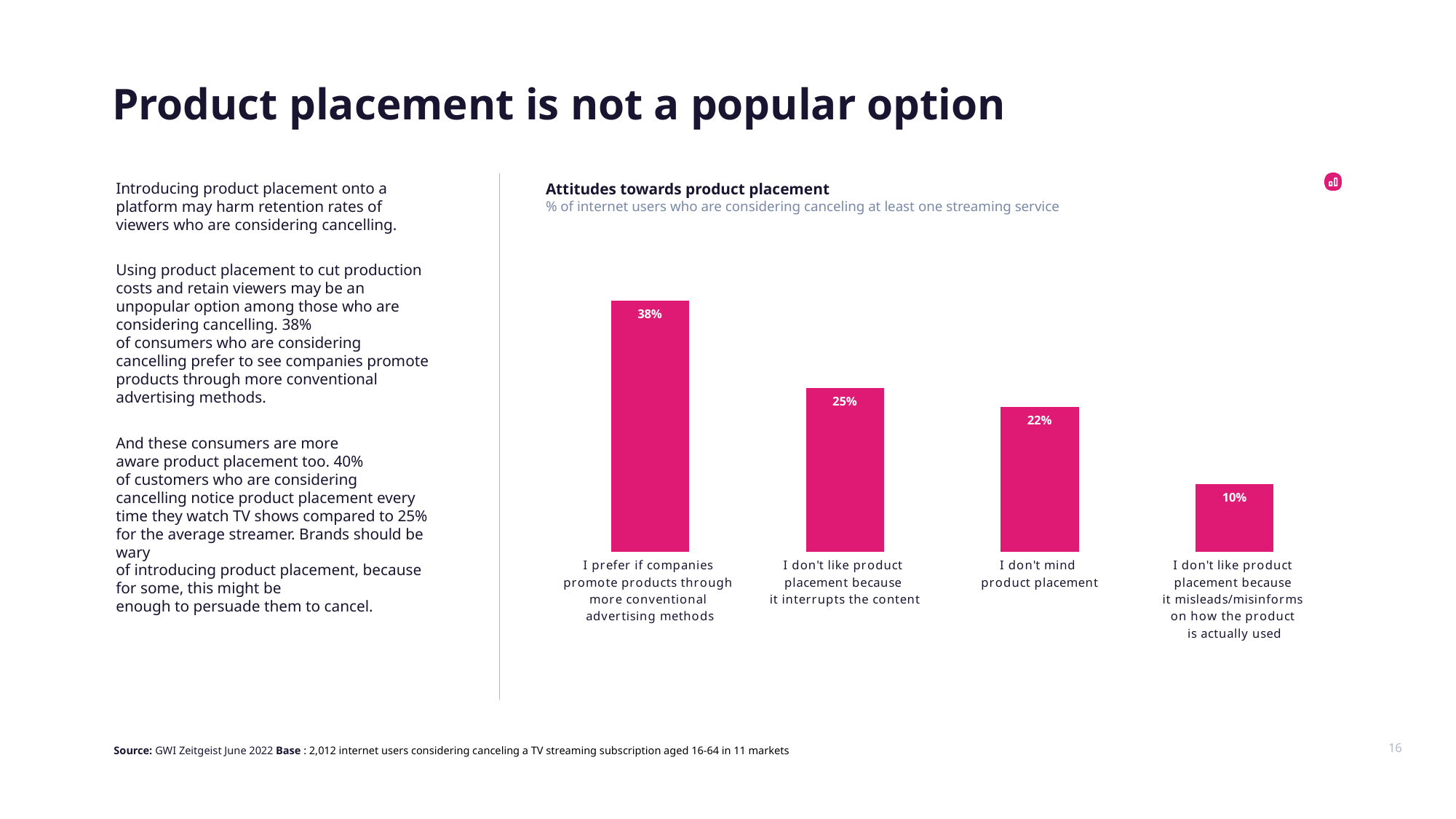
How many attitude categories are shown in the chart? 4 Which attitude has the highest percentage in the chart? I prefer if companies promote products through more conventional advertising methods What is the value for "I don't like product placement because it misleads/misinforms on how the product is actually used"? 10% Which attitude has the lowest percentage in the chart? I don't like product placement because it misleads/misinforms on how the product is actually used Do the values rise or fall moving from left to right across the chart? Fall Which is larger: the value for "I don't like product placement because it interrupts the content" or the value for "I don't mind product placement"? I don't like product placement because it interrupts the content What type of chart is used to show attitudes towards product placement? Bar chart What percentage say "I don't mind product placement"? 22% What is the title of the chart? Attitudes towards product placement What is the difference in percentage points between "I prefer if companies promote products through more conventional advertising methods" and "I don't mind product placement"? 16 percentage points What is the value for "I don't like product placement because it interrupts the content"? 25% What percentage of internet users considering canceling a streaming service say they prefer if companies promote products through more conventional advertising methods? 38%